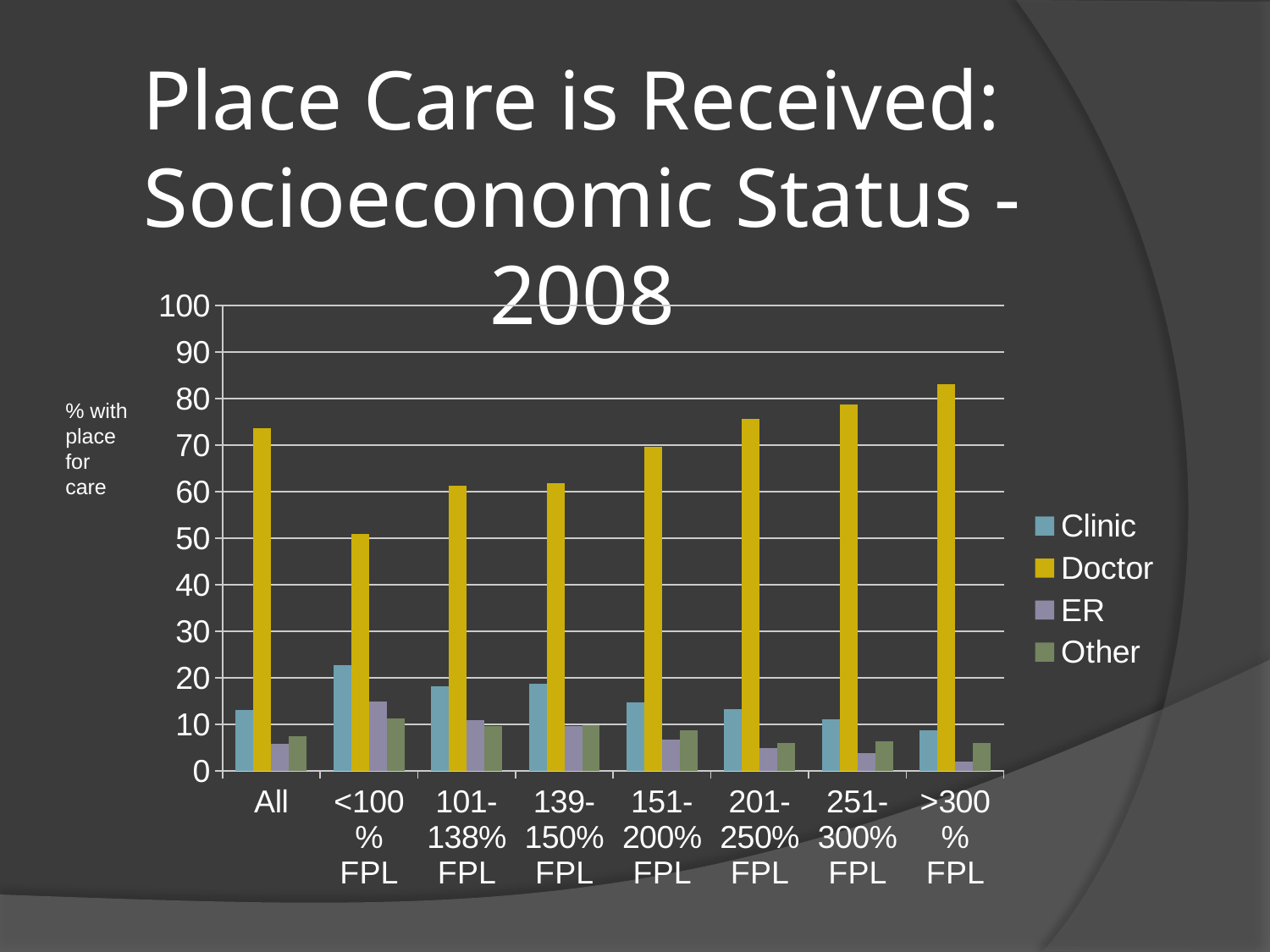
How many series does the legend list? 4 Which income category has the lowest Doctor value? <100% FPL Is the Doctor value for <100% FPL greater or less than 60? less Which is larger for the 151-200% FPL group, the Clinic value or the ER value? Clinic Moving from <100% FPL to >300% FPL, do the Doctor values rise or fall? rise What label is shown on the y axis of the chart? % with place for care Which income category has the highest Clinic value? <100% FPL Is the Doctor value for >300% FPL greater or less than 80? greater How many income categories are shown along the x axis? 8 What kind of chart is shown on the slide? bar chart Is the Clinic value for <100% FPL greater or less than 20? greater Which income category has the highest Doctor value? >300% FPL